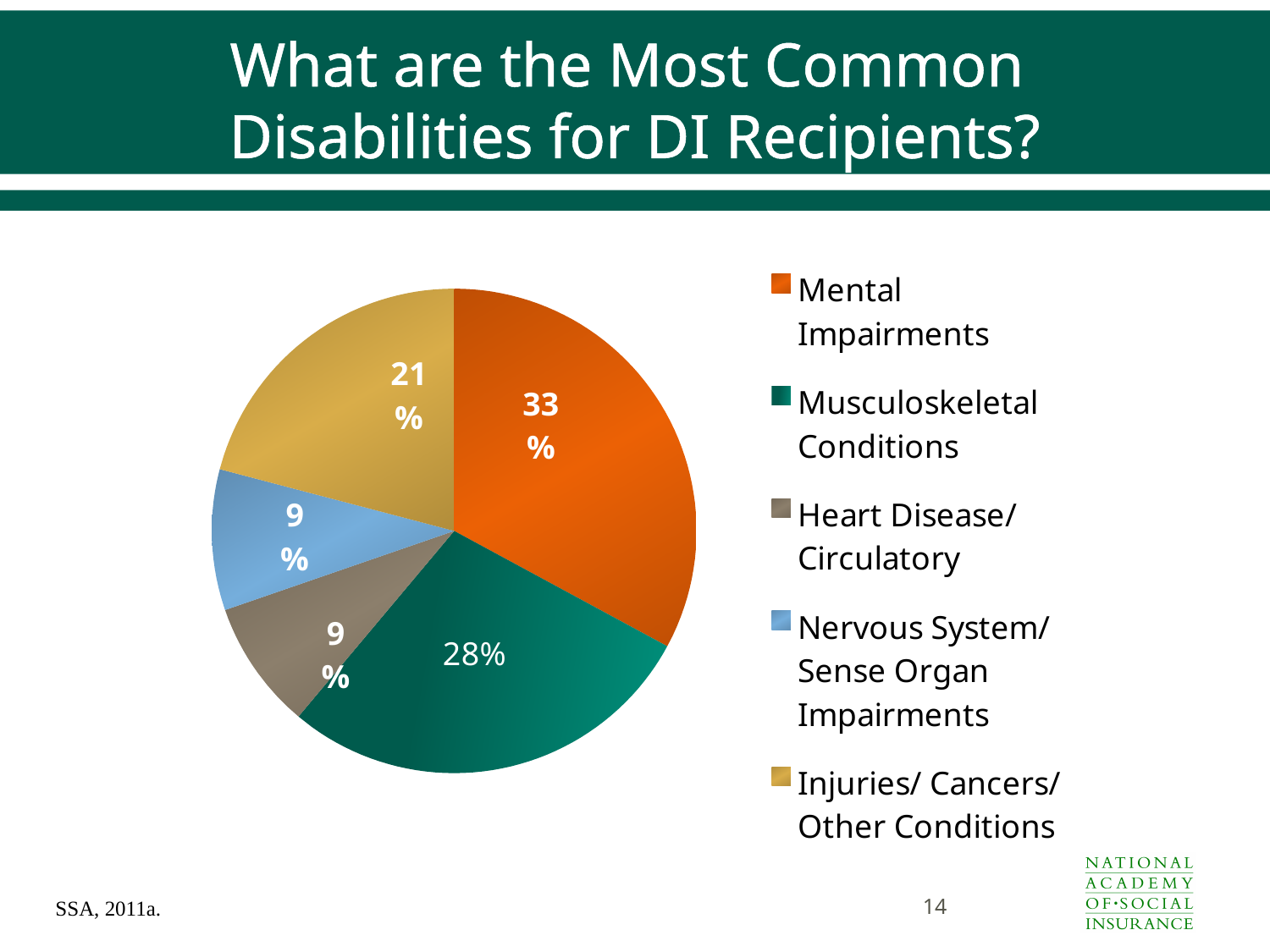
What is the difference in percentage points between Injuries/ Cancers/ Other Conditions and Nervous System/ Sense Organ Impairments? 12 What is the difference in percentage points between Mental Impairments and Musculoskeletal Conditions? 5 What share of DI recipients have Injuries/ Cancers/ Other Conditions? 21% What colour is the slice for Musculoskeletal Conditions? green What kind of chart is shown on the slide? pie chart What share of DI recipients have Mental Impairments? 33% What is the title of the slide containing the chart? What are the Most Common Disabilities for DI Recipients? What share of DI recipients have Heart Disease/ Circulatory conditions? 9% Which category has the largest slice of the pie? Mental Impairments What share of DI recipients have Musculoskeletal Conditions? 28% Which is larger: the share for Musculoskeletal Conditions or the share for Injuries/ Cancers/ Other Conditions? Musculoskeletal Conditions How many categories does the legend list? 5